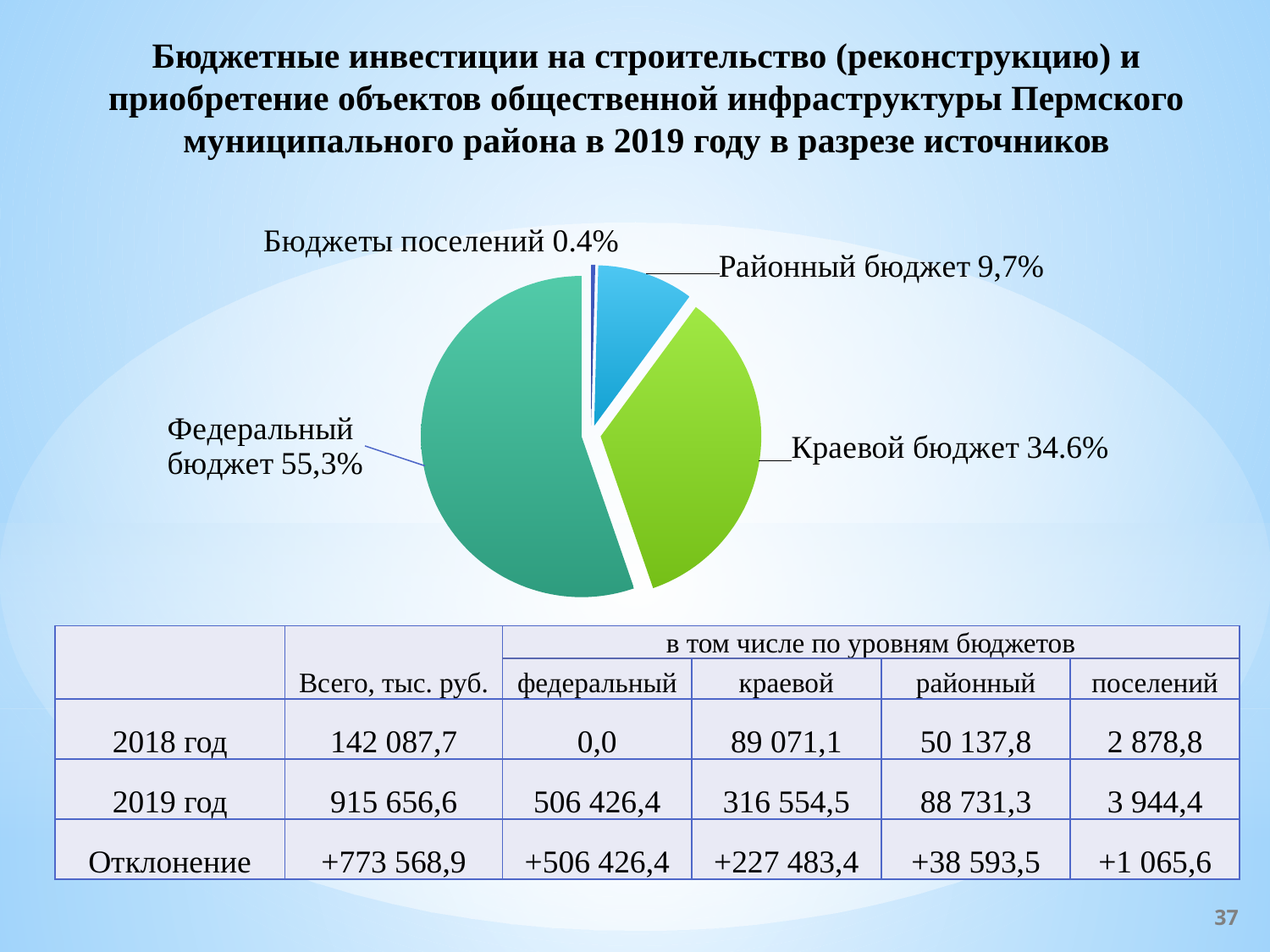
What is the difference in percentage points between the Федеральный бюджет and Краевой бюджет slices? 20.7 What kind of chart is shown on the slide? pie chart What colour is the Федеральный бюджет slice in the pie chart? teal green How many slices does the pie chart have? 4 Which source has the smallest slice of the pie chart? Бюджеты поселений What share of the pie does Федеральный бюджет have? 55,3% What share of the pie does Бюджеты поселений have? 0.4% Which source has the largest slice of the pie chart? Федеральный бюджет What share of the pie does Краевой бюджет have? 34.6% Is the share of Районный бюджет greater or less than 10%? less Which slice is larger in the pie chart: Краевой бюджет or Районный бюджет? Краевой бюджет